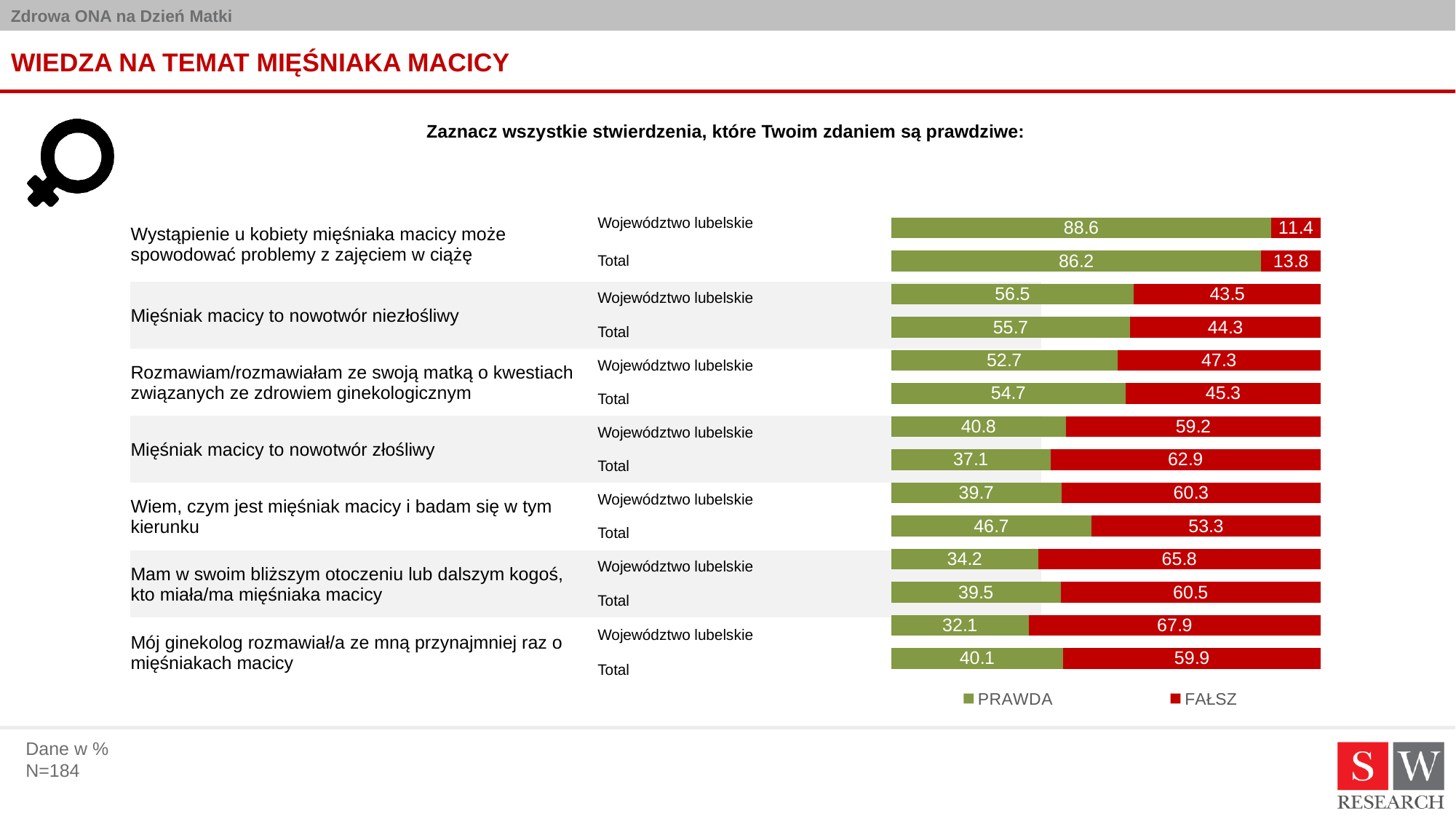
What is the FAŁSZ value for 'Total' on the statement 'Mięśniak macicy to nowotwór złośliwy'? 62.9 What kind of chart is shown on the slide? Stacked horizontal bar chart What is the total of the stacked bar for 'Total' on the statement 'Mam w swoim bliższym otoczeniu lub dalszym kogoś, kto miała/ma mięśniaka macicy'? 100.0 What is the difference between the PRAWDA values for 'Województwo lubelskie' and 'Total' on the statement 'Wiem, czym jest mięśniak macicy i badam się w tym kierunku'? 7.0 How many bars are plotted in the chart? 14 Which bar has the lowest PRAWDA value? Województwo lubelskie, 'Mój ginekolog rozmawiał/a ze mną przynajmniej raz o mięśniakach macicy' (32.1) What is the PRAWDA value for 'Total' on the statement 'Mój ginekolog rozmawiał/a ze mną przynajmniej raz o mięśniakach macicy'? 40.1 Which colour represents the FAŁSZ series in the chart? Red What is the PRAWDA value for 'Województwo lubelskie' on the statement 'Wystąpienie u kobiety mięśniaka macicy może spowodować problemy z zajęciem w ciążę'? 88.6 For the statement 'Mięśniak macicy to nowotwór niezłośliwy', which is larger: the PRAWDA value for 'Województwo lubelskie' or for 'Total'? Województwo lubelskie (56.5) Which bar has the highest PRAWDA value? Województwo lubelskie, 'Wystąpienie u kobiety mięśniaka macicy może spowodować problemy z zajęciem w ciążę' (88.6) How many series does the legend list? 2